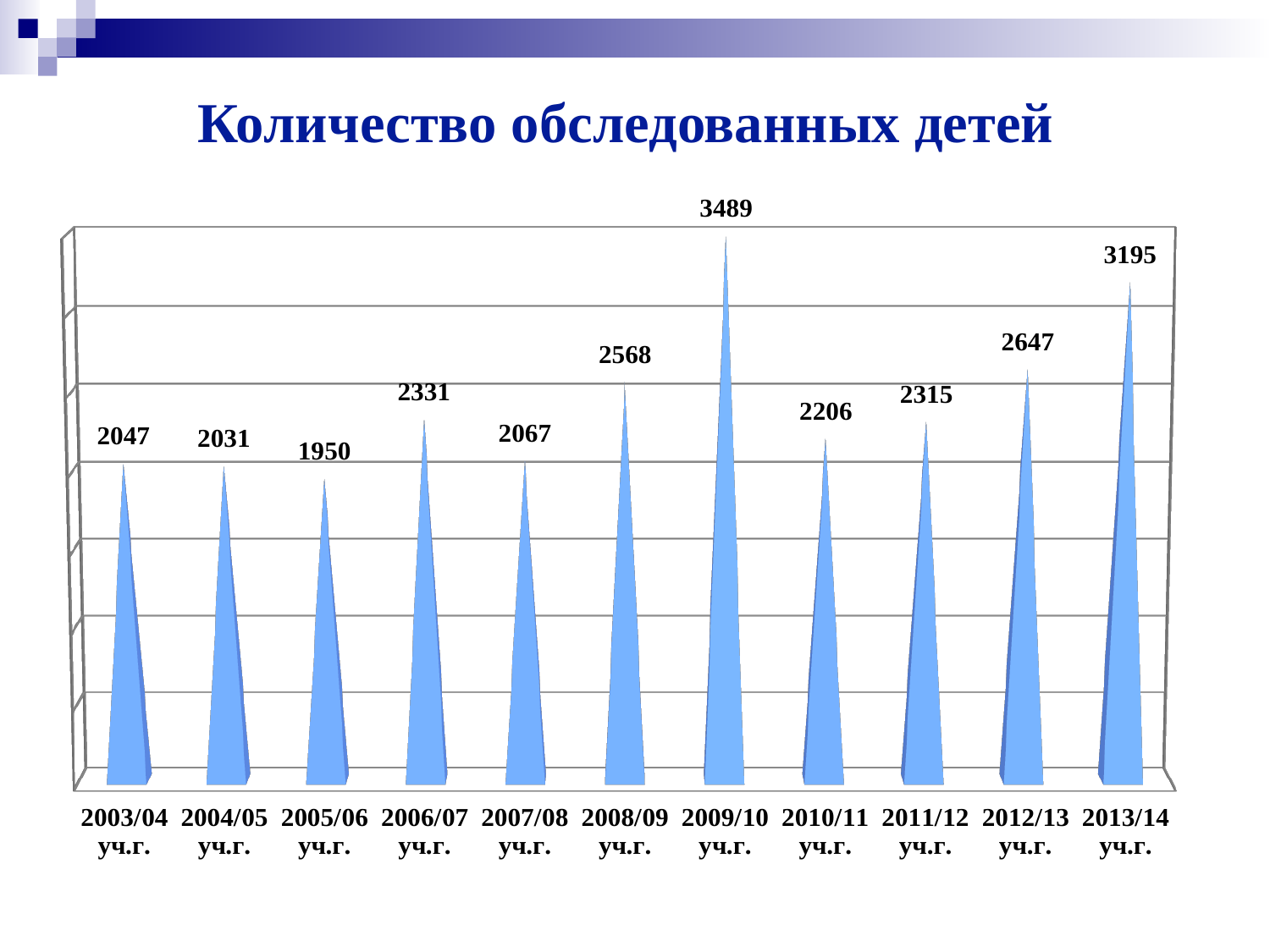
What is the title of the chart? Количество обследованных детей What is the value for 2009/10 уч.г.? 3489 What is the value for 2011/12 уч.г.? 2315 Which academic year has the highest value? 2009/10 уч.г. How many academic years are shown on the x axis? 11 What is the value for 2013/14 уч.г.? 3195 What is the difference between the values for 2012/13 уч.г. and 2010/11 уч.г.? 441 What kind of chart is shown on the slide? bar chart What is the difference between the values for 2009/10 уч.г. and 2013/14 уч.г.? 294 Which academic year has the lowest value? 2005/06 уч.г. What is the value for 2005/06 уч.г.? 1950 Which is larger, the value for 2008/09 уч.г. or the value for 2012/13 уч.г.? 2012/13 уч.г.